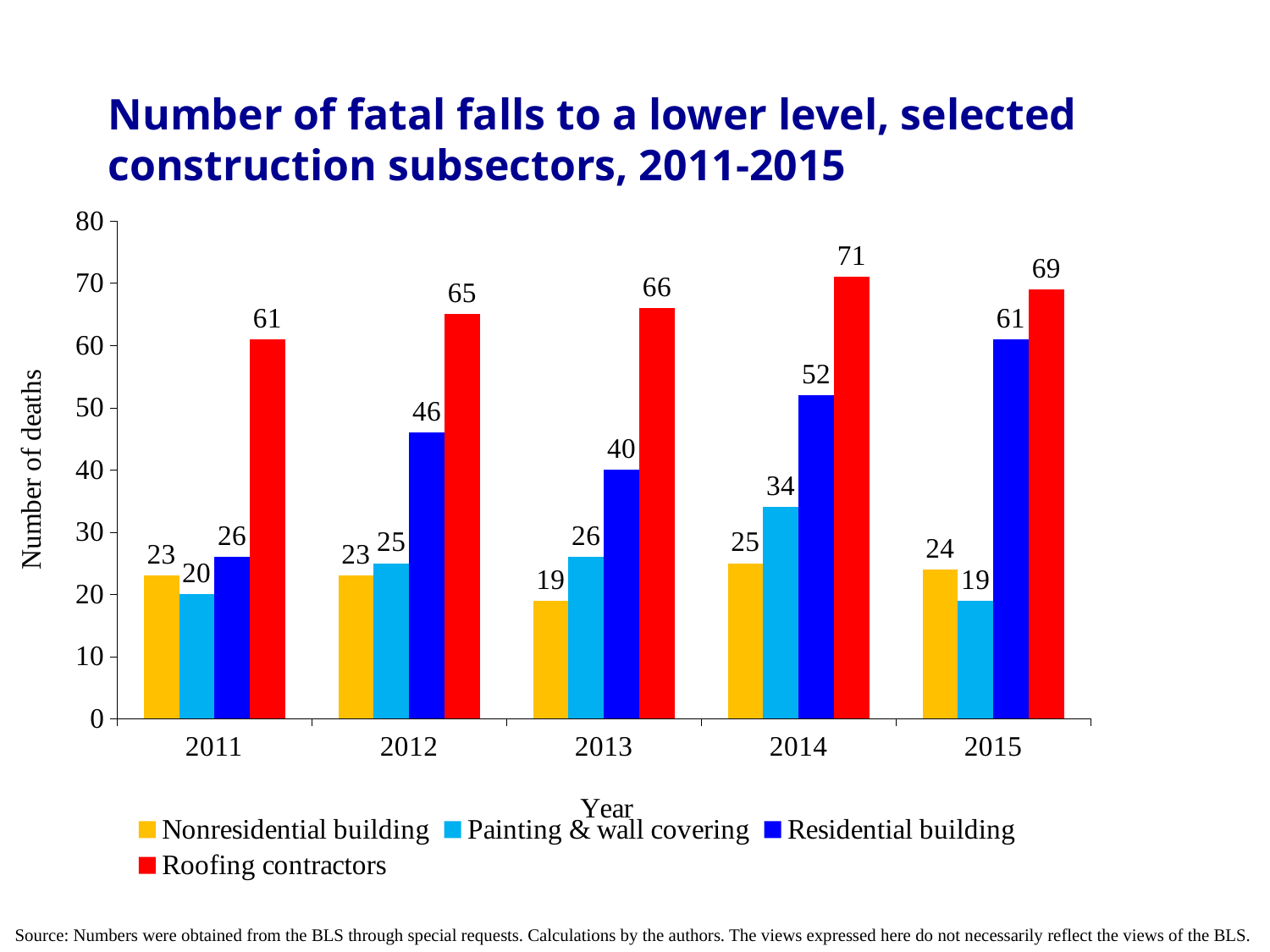
In which year was the number of deaths for Roofing contractors highest? 2014 What is the difference between Roofing contractors and Residential building deaths in 2015? 8 Does the number of deaths for Residential building rise or fall from 2011 to 2015? rise What is the number of deaths for Roofing contractors in 2014? 71 What is the number of deaths for Residential building in 2012? 46 Which colour represents Roofing contractors in the legend? red Which had more deaths in 2013: Nonresidential building or Painting & wall covering? Painting & wall covering In which year was the number of deaths for Residential building lowest? 2011 How many years are shown on the x axis? 5 How many series does the legend list? 4 What kind of chart is shown on the slide? bar chart What is the number of deaths for Painting & wall covering in 2015? 19